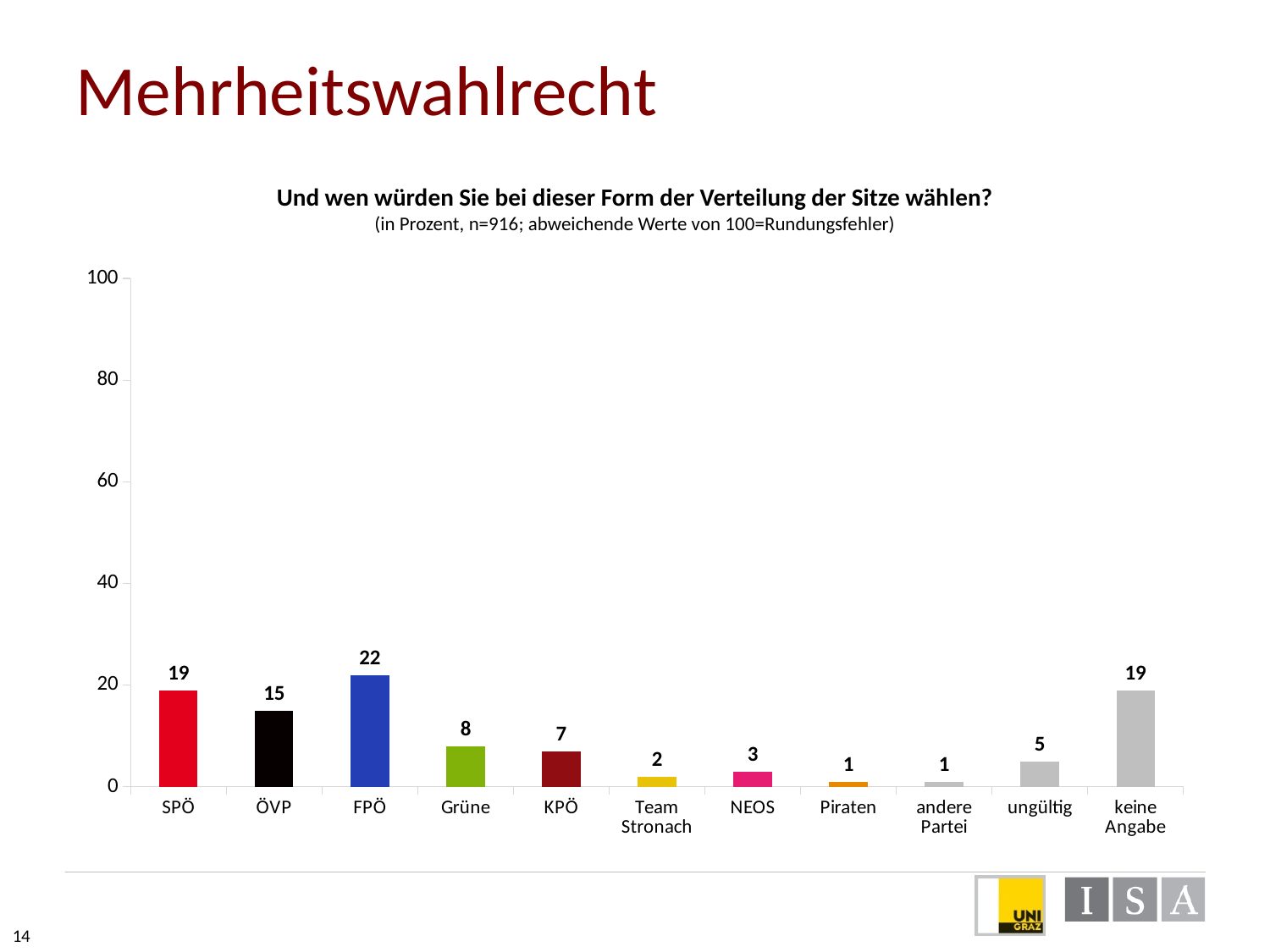
How many categories are shown on the x axis? 11 What kind of chart is shown on the slide? bar chart What is the value for NEOS? 3 Which is larger, the value for SPÖ or the value for ÖVP? SPÖ Is the value for keine Angabe greater or less than 20? less What is the difference between the values for FPÖ and ÖVP? 7 What is the value for Grüne? 8 What is the difference between the values for KPÖ and Team Stronach? 5 Which category has the highest value? FPÖ What is the value for FPÖ? 22 What is the value for ungültig? 5 What is the sample size (n) stated in the chart subtitle? 916